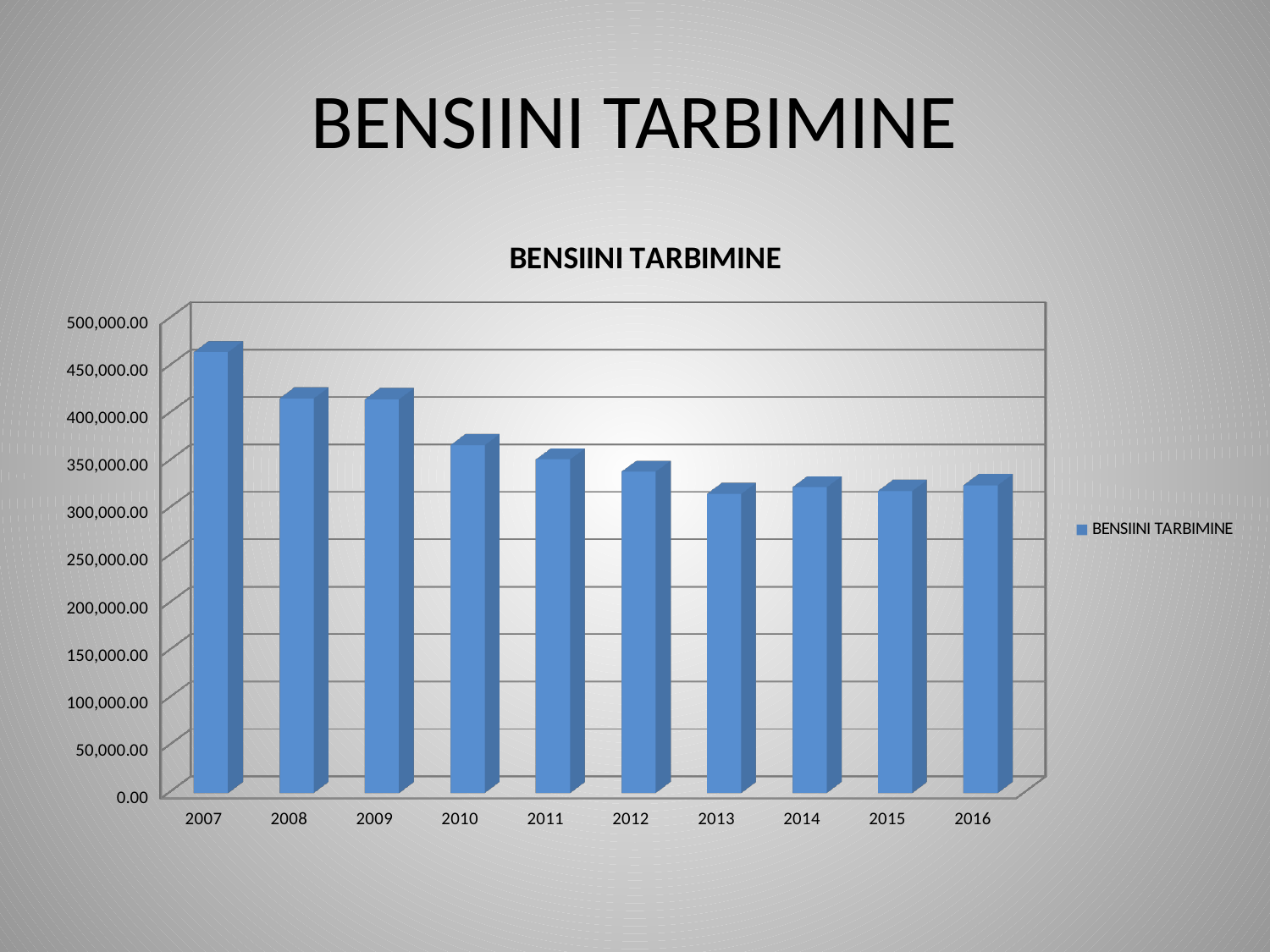
Do the values generally rise or fall from 2007 to 2016? fall Which year has the highest value in the chart? 2007 Is the value for 2007 greater or less than 400,000.00? greater Is the value for 2010 greater or less than 350,000.00? greater How many series does the legend list? 1 Which is larger, the value for 2007 or the value for 2016? 2007 What is the title of the chart? BENSIINI TARBIMINE Is the value for 2013 greater or less than 300,000.00? greater What kind of chart is shown on the slide? bar chart Which is larger, the value for 2010 or the value for 2013? 2010 How many years are shown on the x axis of the chart? 10